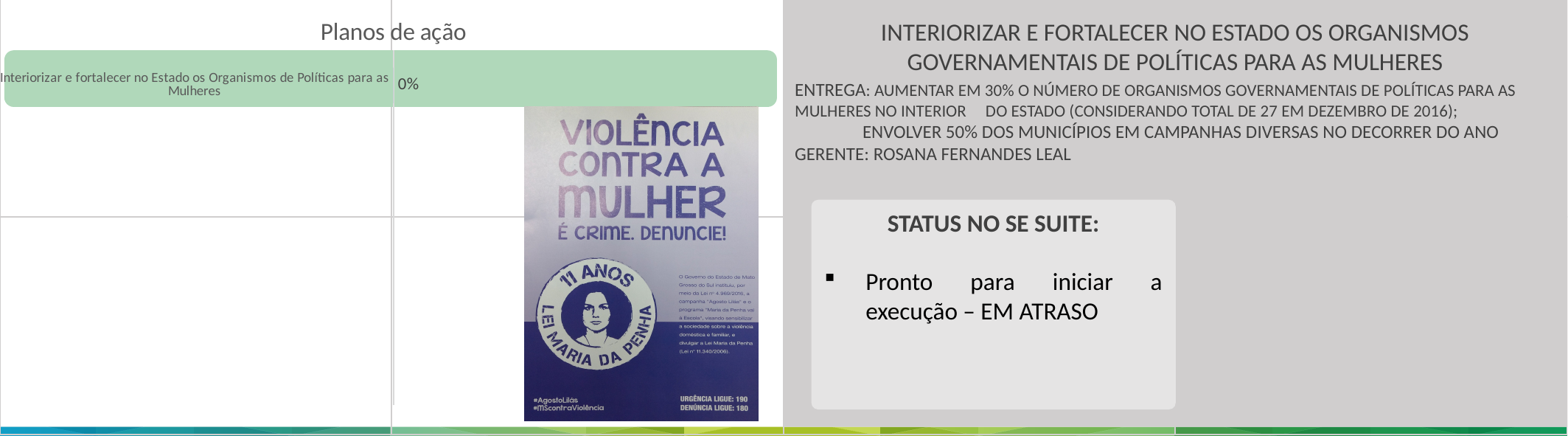
In the 'Planos de ação' chart, what value is shown for 'Interiorizar e fortalecer no Estado os Organismos de Políticas para as Mulheres'? 0% How many categories are plotted in the 'Planos de ação' chart? 1 What kind of chart is the 'Planos de ação' chart? bar chart What is the title of the chart on the left of the slide? Planos de ação What is the label of the only category in the 'Planos de ação' chart? Interiorizar e fortalecer no Estado os Organismos de Políticas para as Mulheres